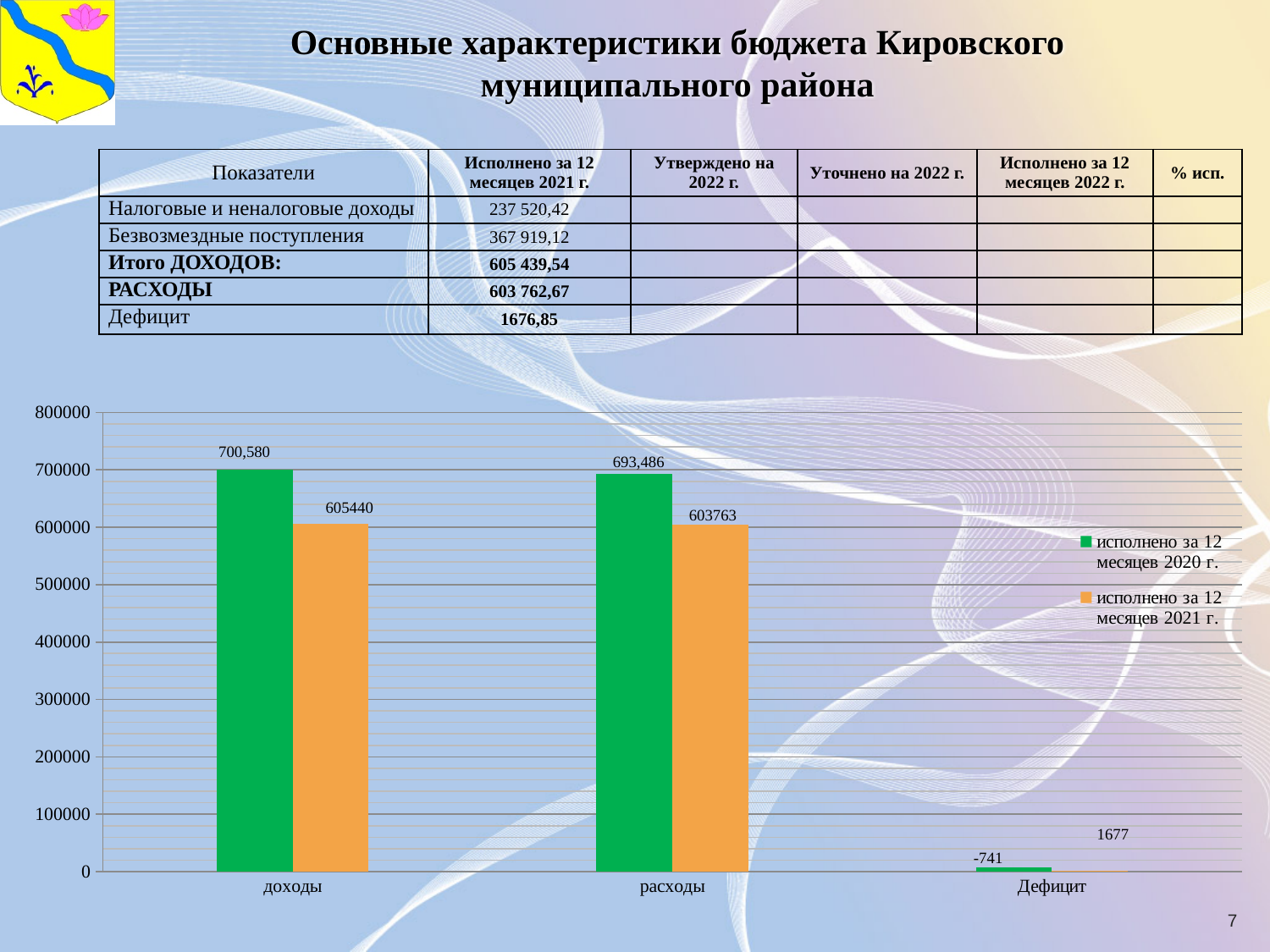
Which category has the lowest value in the series исполнено за 12 месяцев 2020 г.? Дефицит What is the value for расходы in the series исполнено за 12 месяцев 2020 г.? 693,486 What type of chart is shown on the slide? bar chart How many series does the chart legend list? 2 What is the value for Дефицит in the series исполнено за 12 месяцев 2020 г.? -741 How many categories are shown on the x axis of the chart? 3 Which is larger for расходы: the value for исполнено за 12 месяцев 2020 г. or for исполнено за 12 месяцев 2021 г.? исполнено за 12 месяцев 2020 г. What is the value for расходы in the series исполнено за 12 месяцев 2021 г.? 603763 What is the value for доходы in the series исполнено за 12 месяцев 2020 г.? 700,580 What colour are the bars for the series исполнено за 12 месяцев 2021 г.? orange What is the value for Дефицит in the series исполнено за 12 месяцев 2021 г.? 1677 What is the value for доходы in the series исполнено за 12 месяцев 2021 г.? 605440